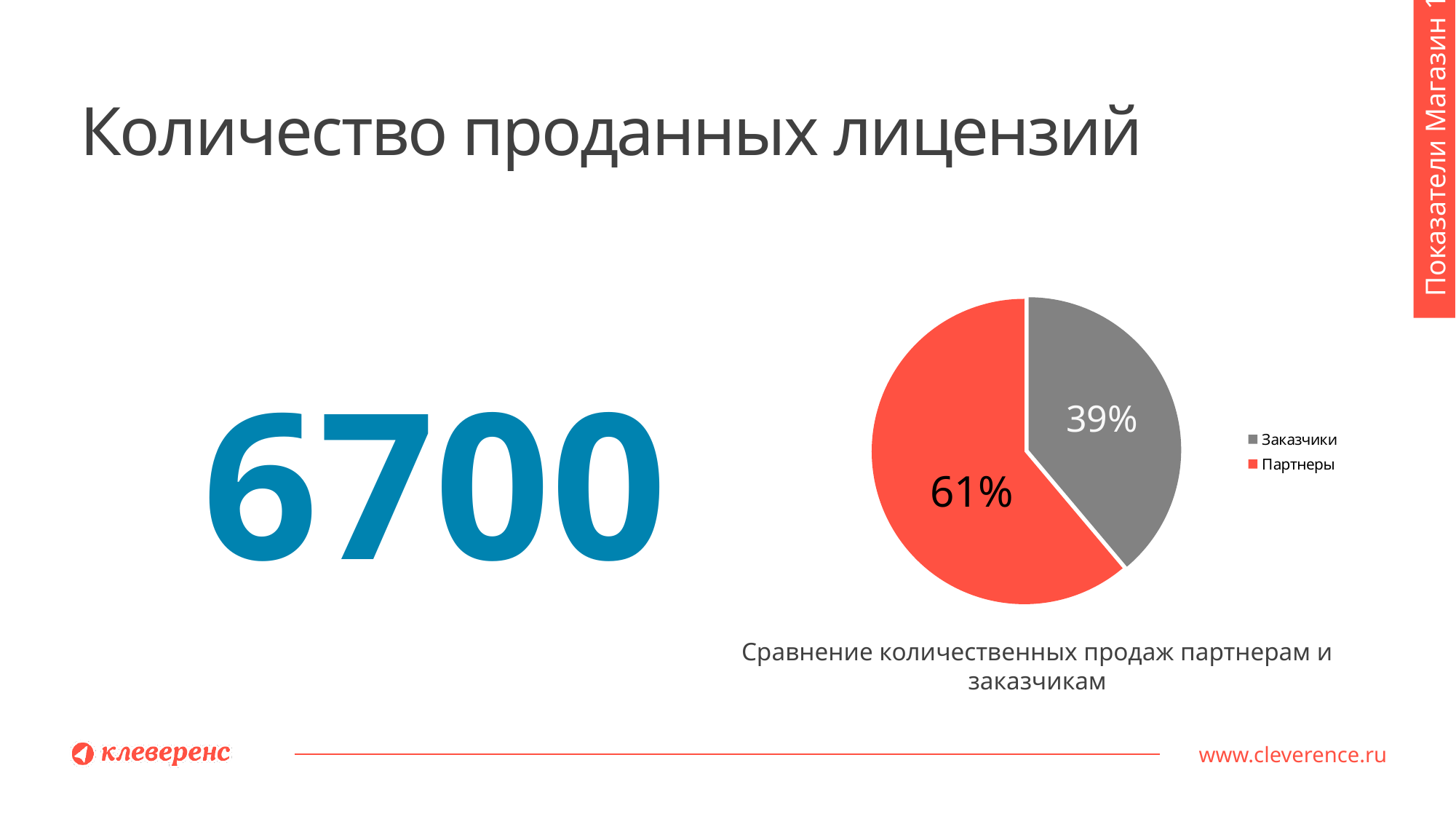
What kind of chart is shown on the slide? pie chart What colour is the Партнеры slice? red Which slice of the pie is the smallest? Заказчики What is the difference in percentage points between the Партнеры and Заказчики slices? 22 Which slice of the pie is the largest? Партнеры What colour is the Заказчики slice? grey How many slices does the pie chart have? 2 Which is larger, the Партнеры slice or the Заказчики slice? Партнеры What share of the pie does Партнеры have? 61% How many entries does the legend list? 2 What share of the pie does Заказчики have? 39%